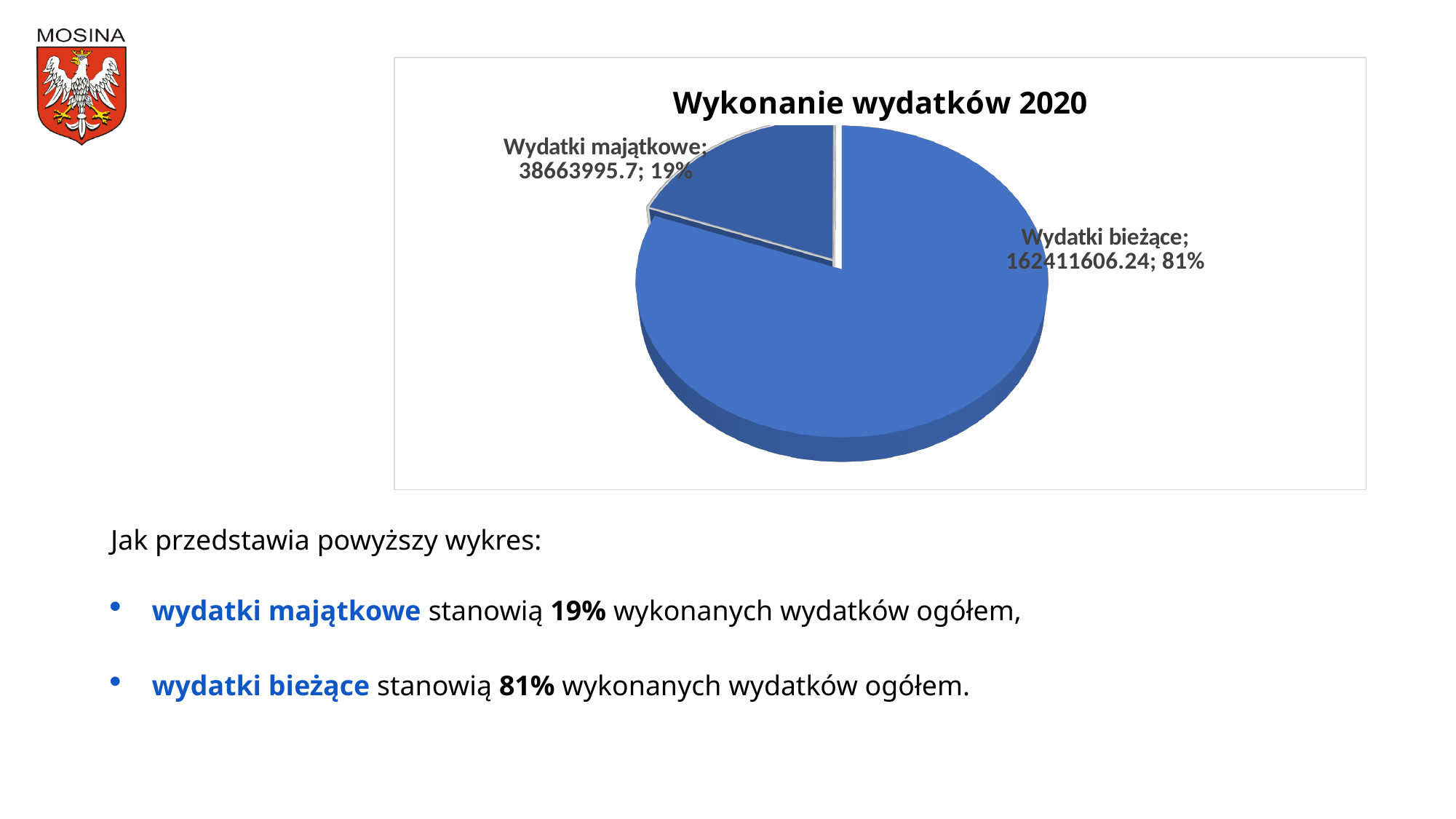
How many slices does the pie chart have? 2 What is the difference between the values for Wydatki bieżące and Wydatki majątkowe? 123747610.54 Which category has the smallest slice of the pie? Wydatki majątkowe What share of the pie does Wydatki majątkowe represent? 19% What is the value for Wydatki bieżące? 162411606.24 What is the total of the two values shown in the pie chart? 201075601.94 What is the title of the chart? Wykonanie wydatków 2020 Which is larger, Wydatki bieżące or Wydatki majątkowe? Wydatki bieżące Which category has the largest slice of the pie? Wydatki bieżące What share of the pie does Wydatki bieżące represent? 81% What type of chart is shown on the slide? pie chart What is the value for Wydatki majątkowe? 38663995.7